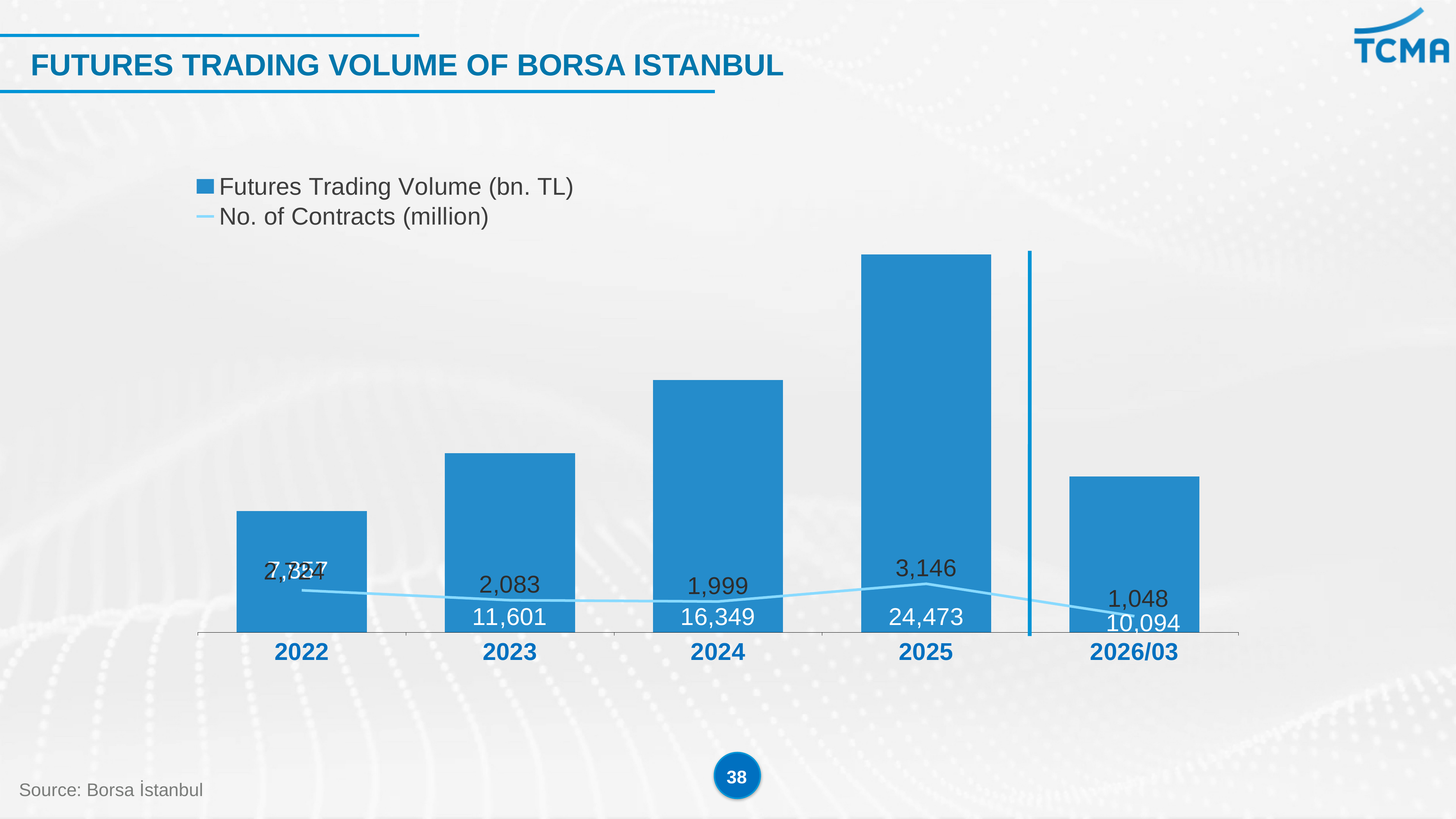
What is the difference in Futures Trading Volume (bn. TL) between 2025 and 2024? 8,124 Which is larger, the Futures Trading Volume (bn. TL) for 2024 or for 2026/03? 2024 What is the Futures Trading Volume (bn. TL) for 2025? 24,473 Which period has the lowest No. of Contracts (million)? 2026/03 Do the Futures Trading Volume (bn. TL) bars rise or fall from 2022 to 2025? rise What is the Futures Trading Volume (bn. TL) for 2023? 11,601 What is the No. of Contracts (million) for 2026/03? 1,048 Which year has the highest Futures Trading Volume (bn. TL)? 2025 How many series does the legend list? 2 What is the No. of Contracts (million) for 2024? 1,999 What is the difference in No. of Contracts (million) between 2025 and 2024? 1,147 How many periods are shown on the x axis? 5